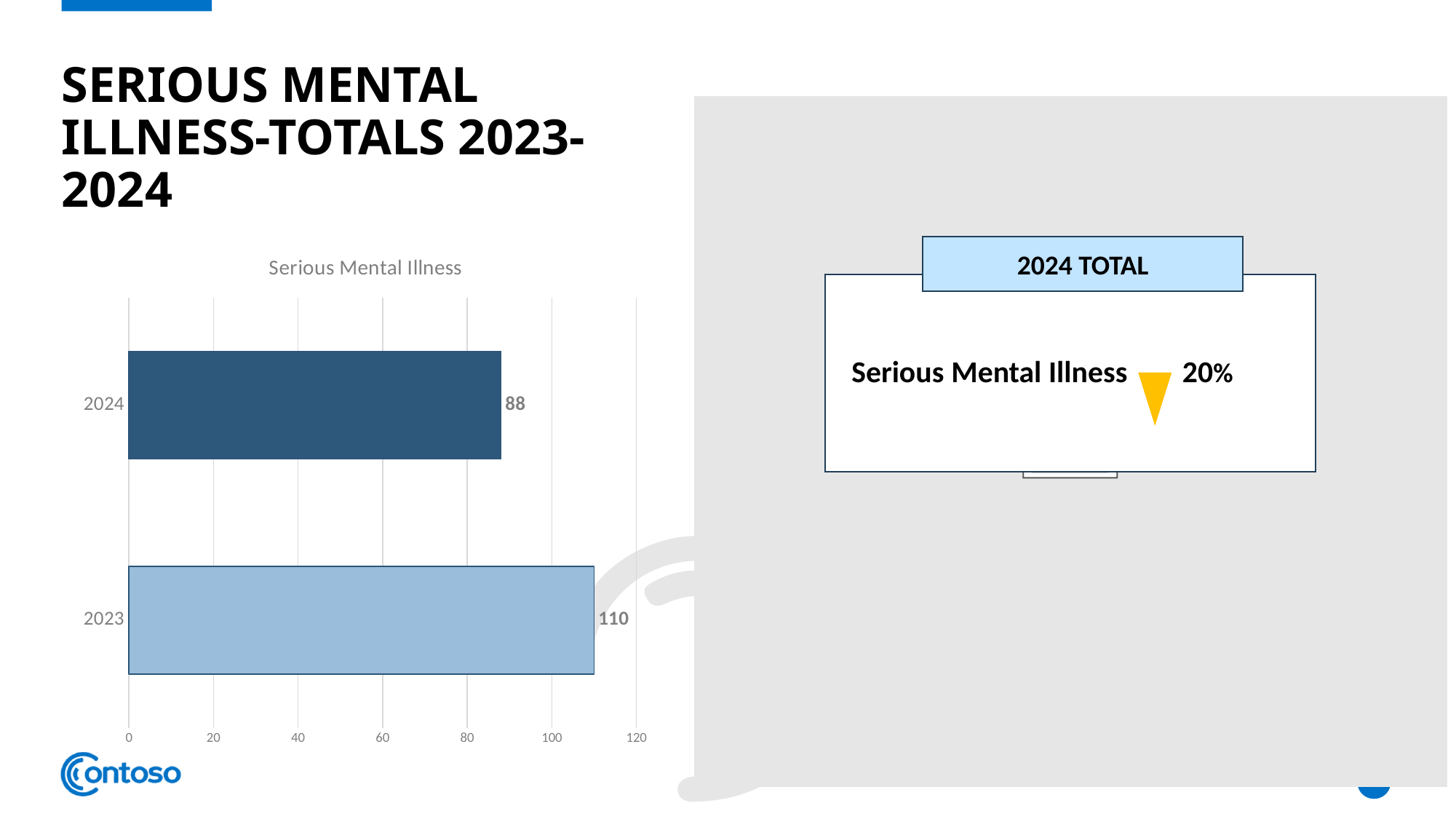
What is the highest value shown on the horizontal axis of the Serious Mental Illness chart? 120 What is the difference between the 2023 and 2024 values in the Serious Mental Illness chart? 22 What is the value for 2023 in the Serious Mental Illness chart? 110 Is the value for 2024 greater or less than 100 in the Serious Mental Illness chart? less Is the value for 2024 larger or smaller than the value for 2023 in the Serious Mental Illness chart? smaller What kind of chart is the Serious Mental Illness chart? bar chart How many bars are shown in the Serious Mental Illness chart? 2 What is the value for 2024 in the Serious Mental Illness chart? 88 What is the title of the chart on the slide? Serious Mental Illness Is the value for 2023 greater or less than 100 in the Serious Mental Illness chart? greater Which year has the lower value in the Serious Mental Illness chart? 2024 Which year has the higher value in the Serious Mental Illness chart? 2023